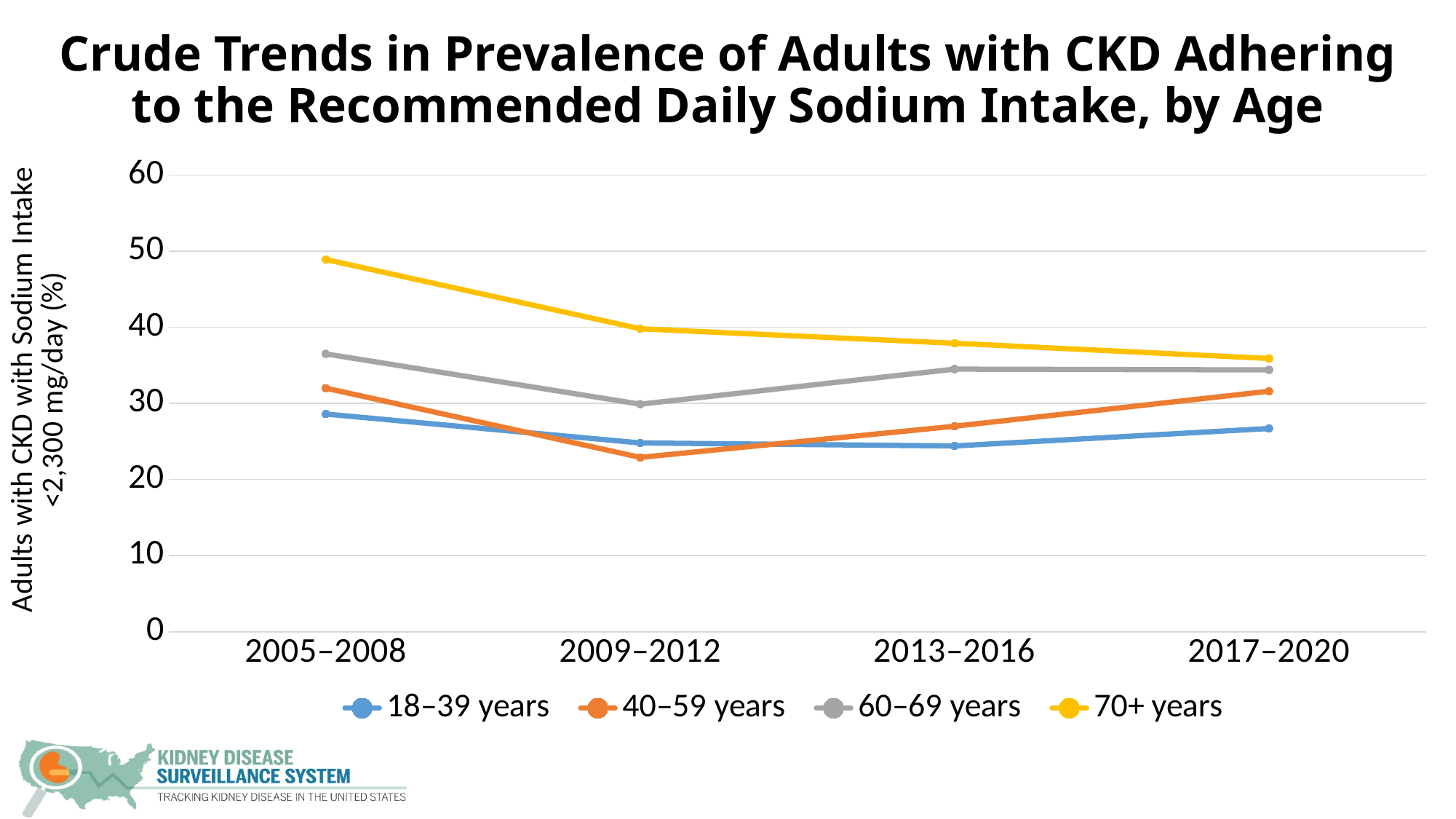
Does the value for 40–59 years rise or fall from 2009–2012 to 2017–2020? Rises What colour is the line for the 70+ years age group? Yellow Does the value for 70+ years rise or fall from 2005–2008 to 2017–2020? Falls In 2013–2016, which is larger: the value for 60–69 years or the value for 40–59 years? 60–69 years Is the value for 70+ years in 2005–2008 greater or less than 40? greater Is the value for 40–59 years in 2009–2012 greater or less than 30? less How many time periods are shown on the x axis? 4 How many age groups does the legend list? 4 What kind of chart is shown on the slide? Line chart Which age group has the lowest value in 2005–2008? 18–39 years Is the value for 18–39 years in 2017–2020 greater or less than 30? less Which age group has the highest value in 2005–2008? 70+ years